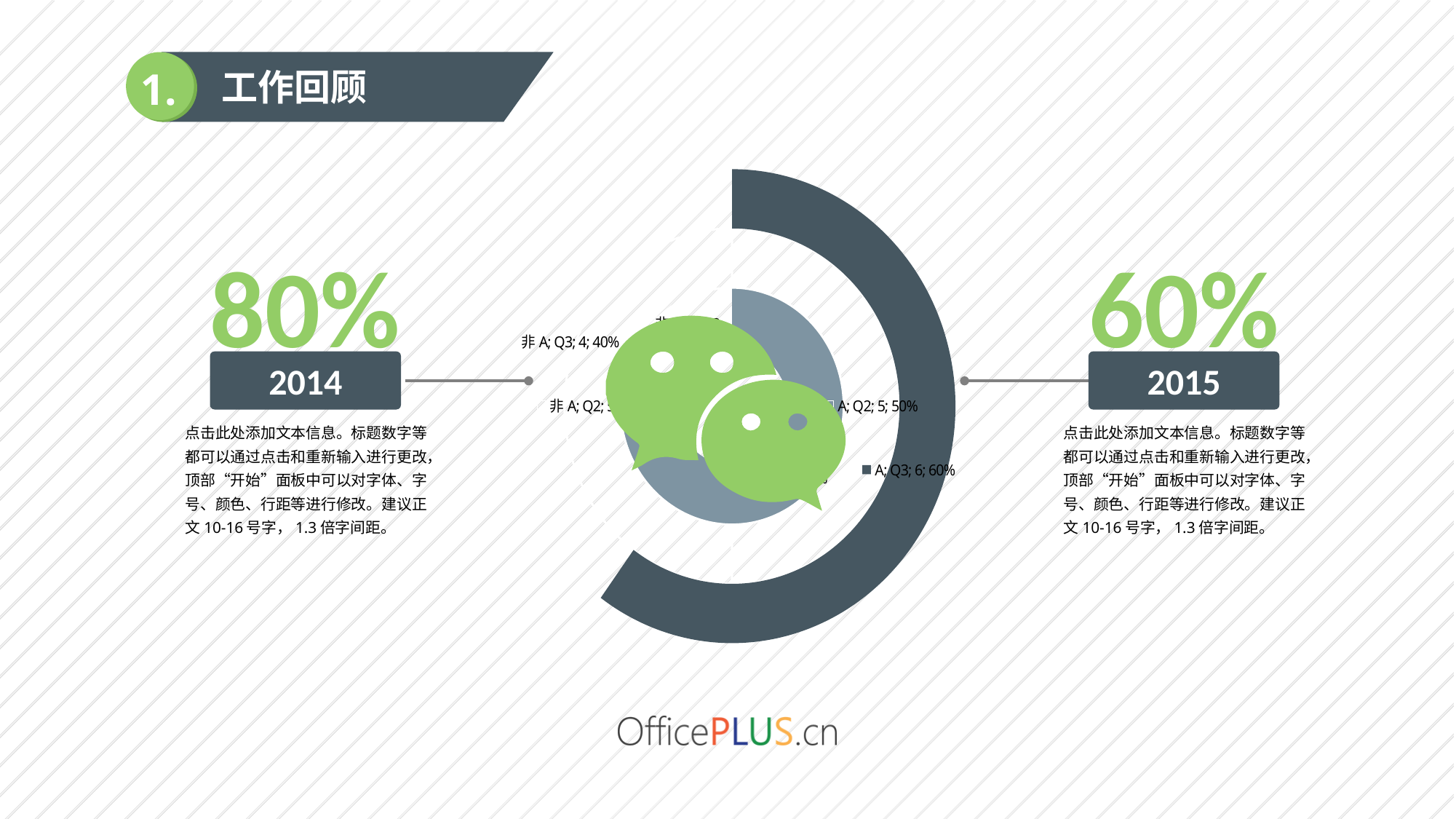
What is the raw value shown in the data label for A in Q3 on the doughnut chart? 6 What percentage is shown for 非 A in Q3 on the doughnut chart? 40% In Q3, which is larger on the doughnut chart, A or 非 A? A What percentage is shown for A in Q2 on the doughnut chart? 50% What is the raw value shown in the data label for 非 A in Q3 on the doughnut chart? 4 What percentage is shown for A in Q3 on the doughnut chart? 60% What do the Q3 percentages for A and 非 A on the doughnut chart add up to? 100% What is the raw value shown in the data label for A in Q2 on the doughnut chart? 5 What kind of chart is shown in the centre of the slide? doughnut chart What is the difference between the Q3 percentages for A and 非 A on the doughnut chart? 20%